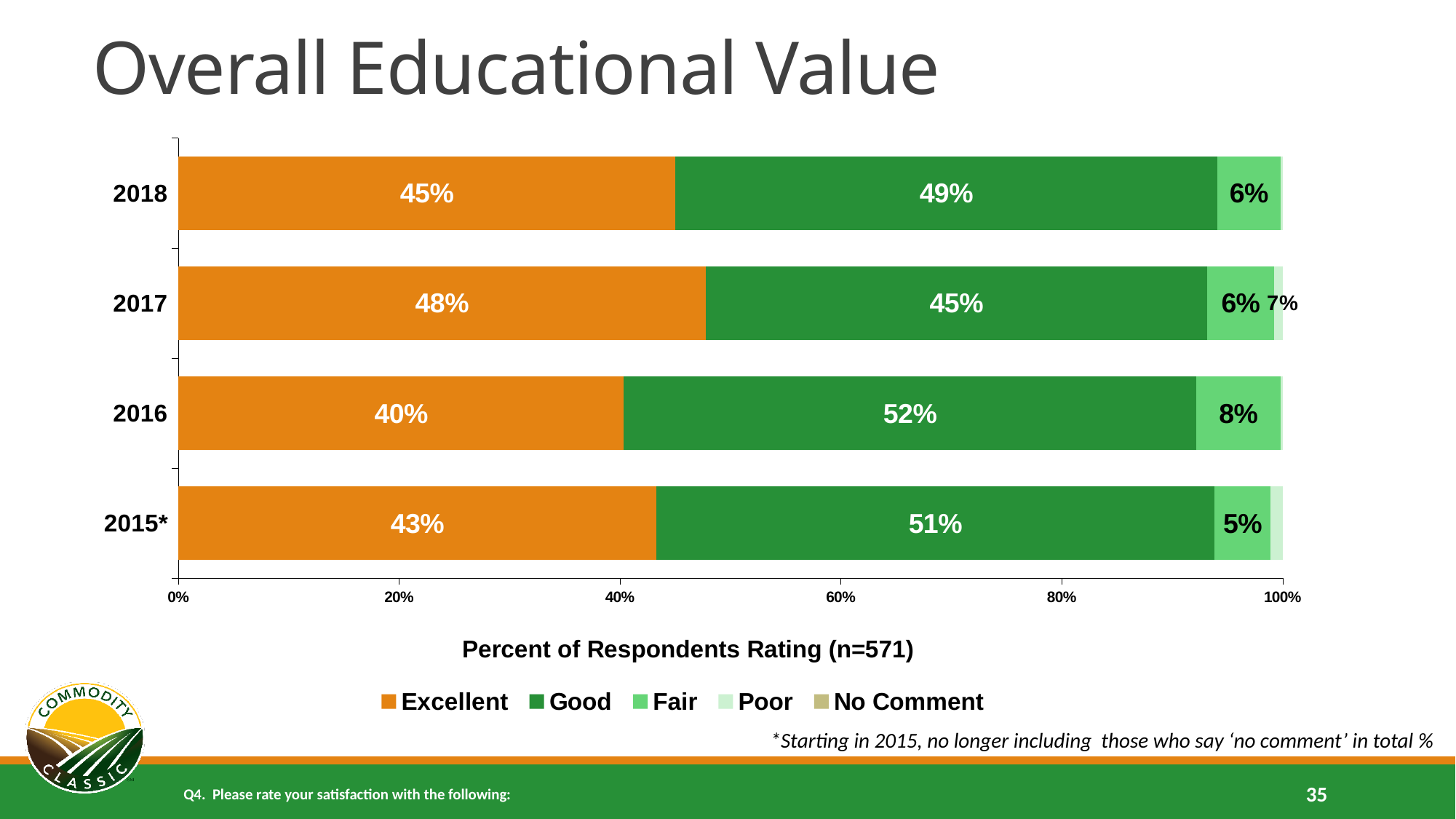
What percentage of respondents rated the overall educational value as Good in 2016? 52% How many series does the legend list? 5 Which year has the lowest Excellent percentage? 2016 What type of chart is shown on the slide? Stacked bar chart Is the Excellent percentage in 2018 larger or smaller than the Good percentage in 2018? smaller What is the difference between the Good percentage in 2016 and the Good percentage in 2017? 7% What percentage of respondents rated the overall educational value as Fair in 2015*? 5% Which year has the highest Excellent percentage? 2017 How many years are shown on the chart? 4 What percentage of respondents rated the overall educational value as Excellent in 2018? 45% Which year has the highest Fair percentage? 2016 What percentage of respondents rated the overall educational value as Excellent in 2017? 48%